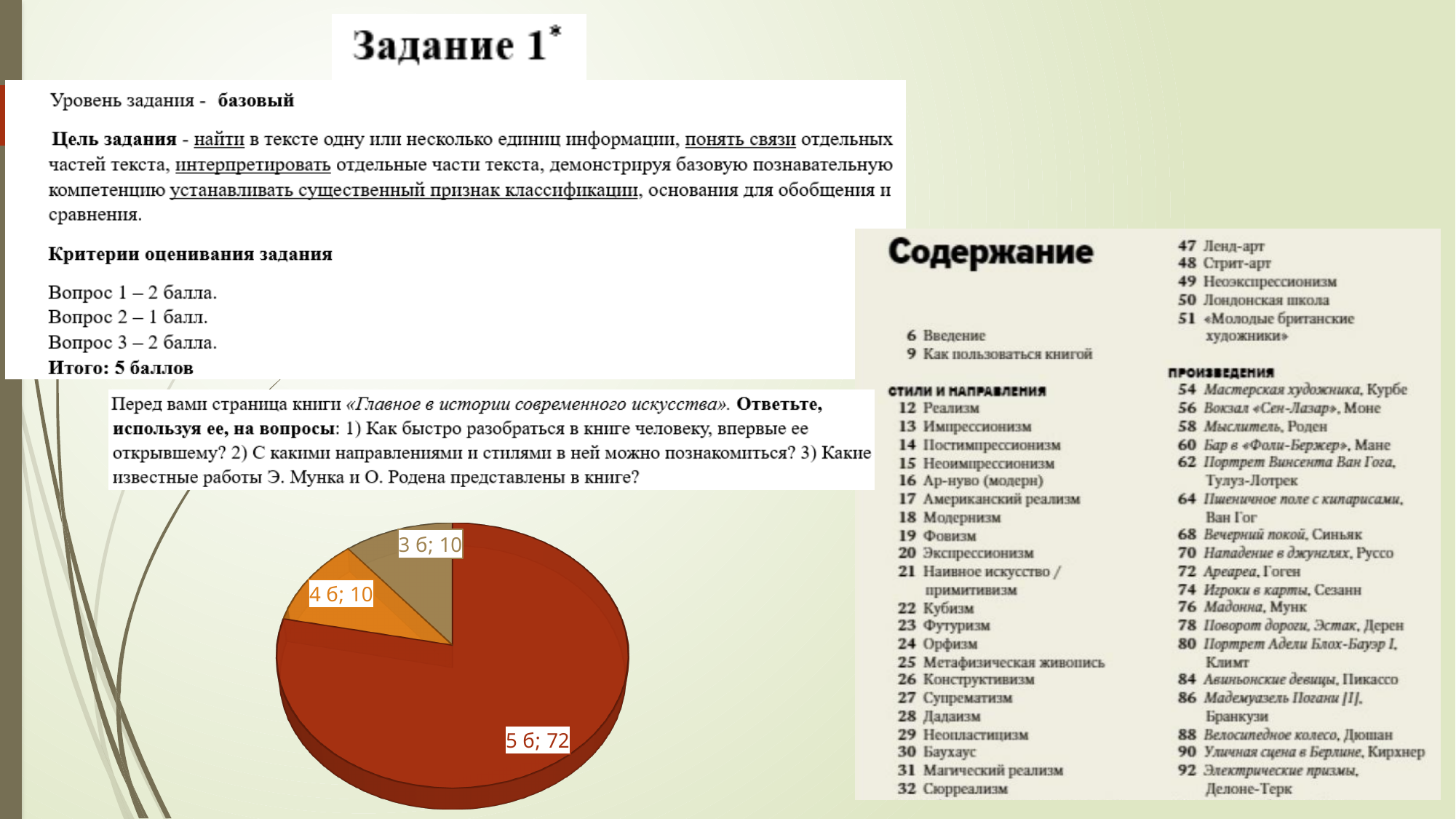
Which slice of the pie chart has the largest value? 5 б Do the "3 б" and "4 б" slices have the same value? Yes What is the value shown for the "3 б" slice of the pie chart? 10 Which slice has the larger value, "5 б" or "4 б"? 5 б What colour is the "4 б" slice of the pie chart? Orange What is the difference between the values of the "5 б" and "3 б" slices? 62 What colour is the largest slice of the pie chart? Dark red What is the value shown for the "5 б" slice of the pie chart? 72 What kind of chart is shown on the slide? Pie chart What is the value shown for the "4 б" slice of the pie chart? 10 How many slices does the pie chart have? 3 What is the sum of the values of all three slices in the pie chart? 92